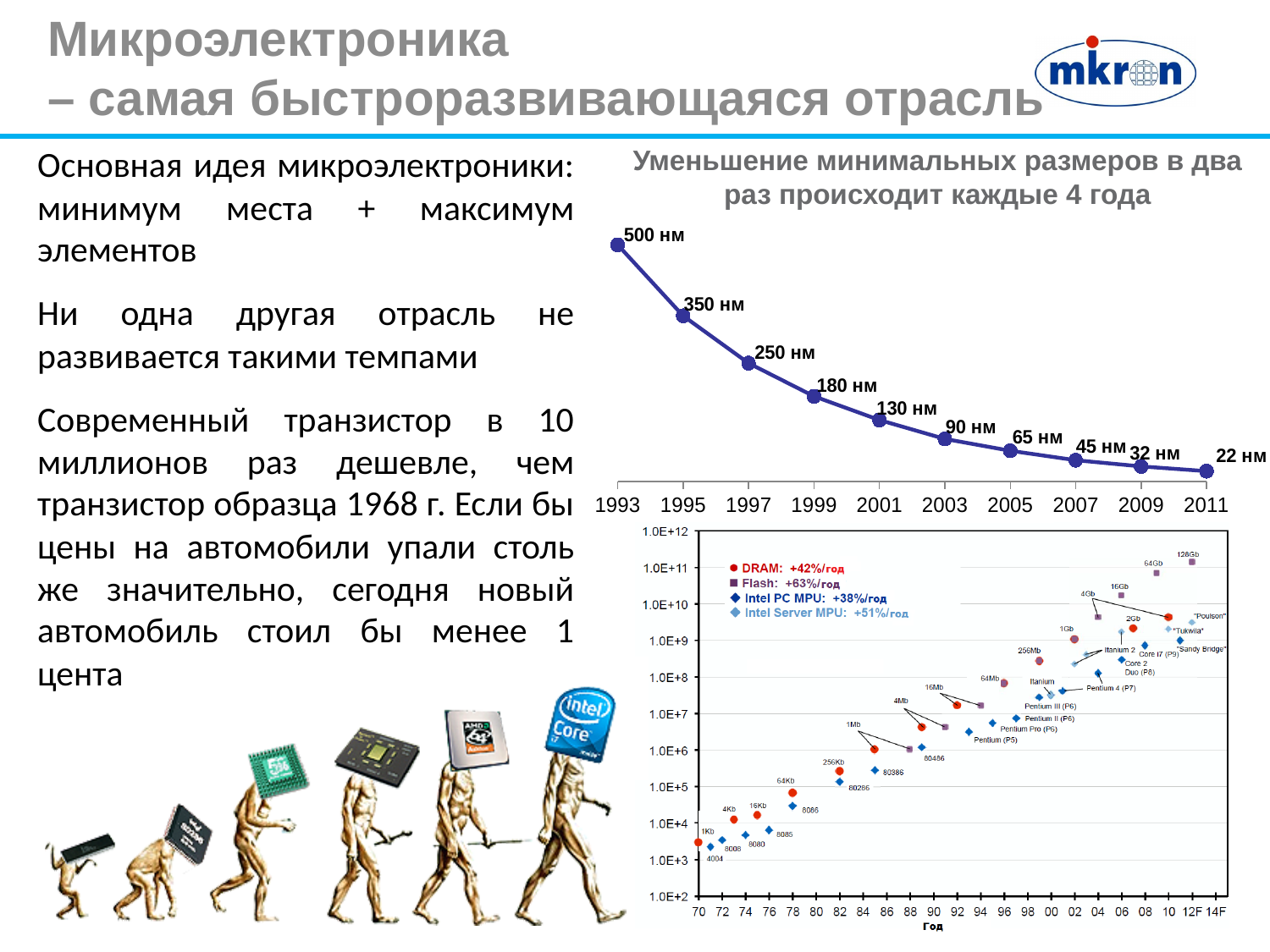
In the top chart titled 'Уменьшение минимальных размеров в два раз происходит каждые 4 года', what is the difference between the values for 1995 and 1997? 100 нм In the top chart titled 'Уменьшение минимальных размеров в два раз происходит каждые 4 года', do the values rise or fall from 1993 to 2011? fall In the top chart titled 'Уменьшение минимальных размеров в два раз происходит каждые 4 года', how many data points are plotted? 10 In the top chart titled 'Уменьшение минимальных размеров в два раз происходит каждые 4 года', what is the value for 1993? 500 нм In the bottom chart, how many series does the legend list? 4 In the top chart titled 'Уменьшение минимальных размеров в два раз происходит каждые 4 года', which is larger, the value for 1999 or the value for 2005? 1999 In the top chart titled 'Уменьшение минимальных размеров в два раз происходит каждые 4 года', what is the value for 2011? 22 нм In the top chart titled 'Уменьшение минимальных размеров в два раз происходит каждые 4 года', what is the value for 2001? 130 нм In the top chart titled 'Уменьшение минимальных размеров в два раз происходит каждые 4 года', which year has the highest value? 1993 What kind of chart is the top chart titled 'Уменьшение минимальных размеров в два раз происходит каждые 4 года'? line chart In the top chart titled 'Уменьшение минимальных размеров в два раз происходит каждые 4 года', what is the difference between the values for 2003 and 2009? 58 нм In the top chart titled 'Уменьшение минимальных размеров в два раз происходит каждые 4 года', which year has the lowest value? 2011